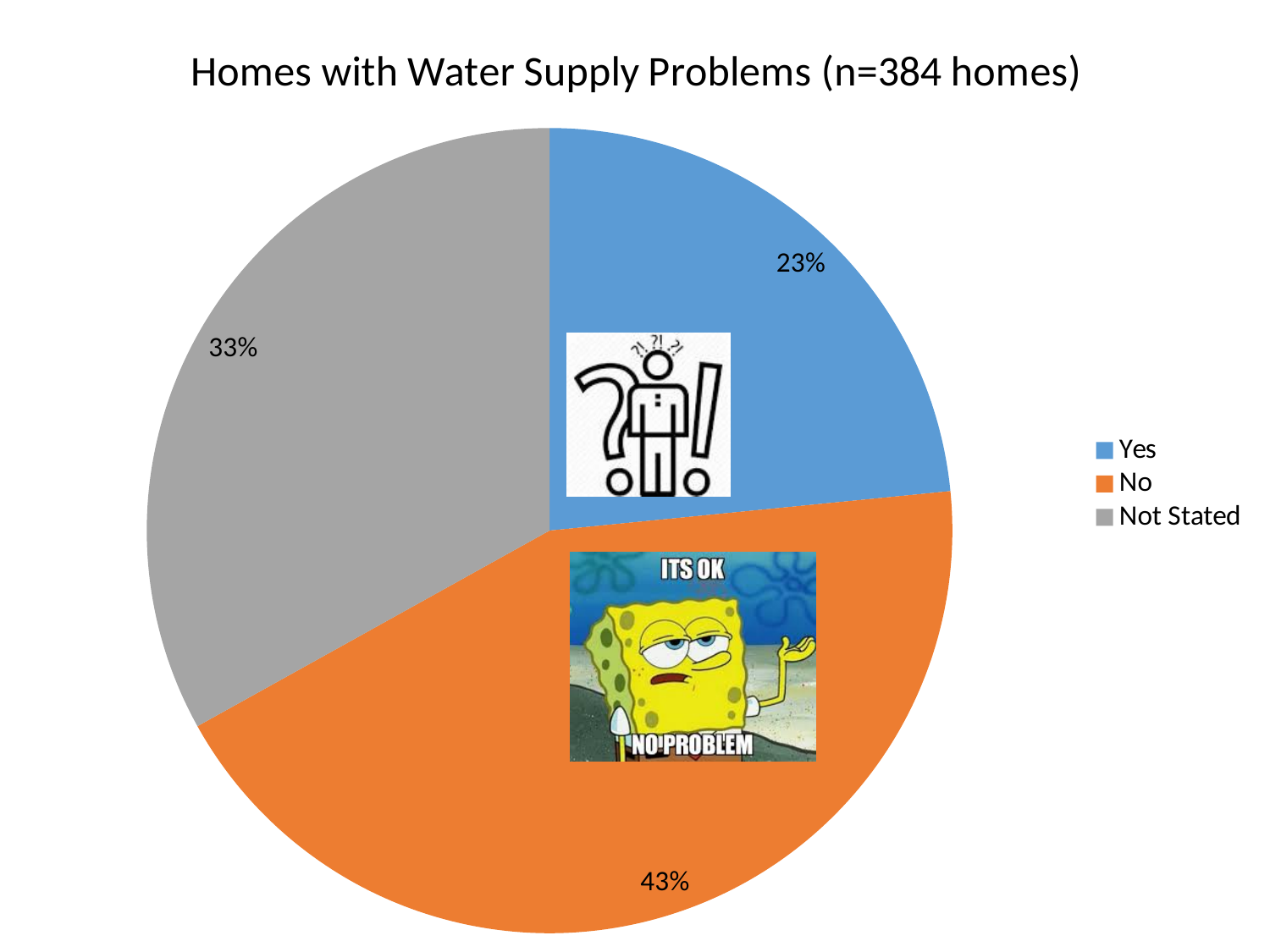
Which category has the largest share of the pie? No Which is larger, the "Not Stated" slice or the "Yes" slice? Not Stated How many categories does the pie chart have? 3 What kind of chart is shown on the slide? pie chart What is the title of the chart? Homes with Water Supply Problems (n=384 homes) What is the difference in percentage points between the "No" and "Yes" slices? 20 Which category has the smallest share of the pie? Yes What percentage of homes answered "Yes" to having water supply problems? 23% What percentage of homes are in the "Not Stated" category? 33% What percentage of homes answered "No"? 43% What colour is the "Not Stated" slice? grey What is the difference in percentage points between the "Not Stated" and "Yes" slices? 10